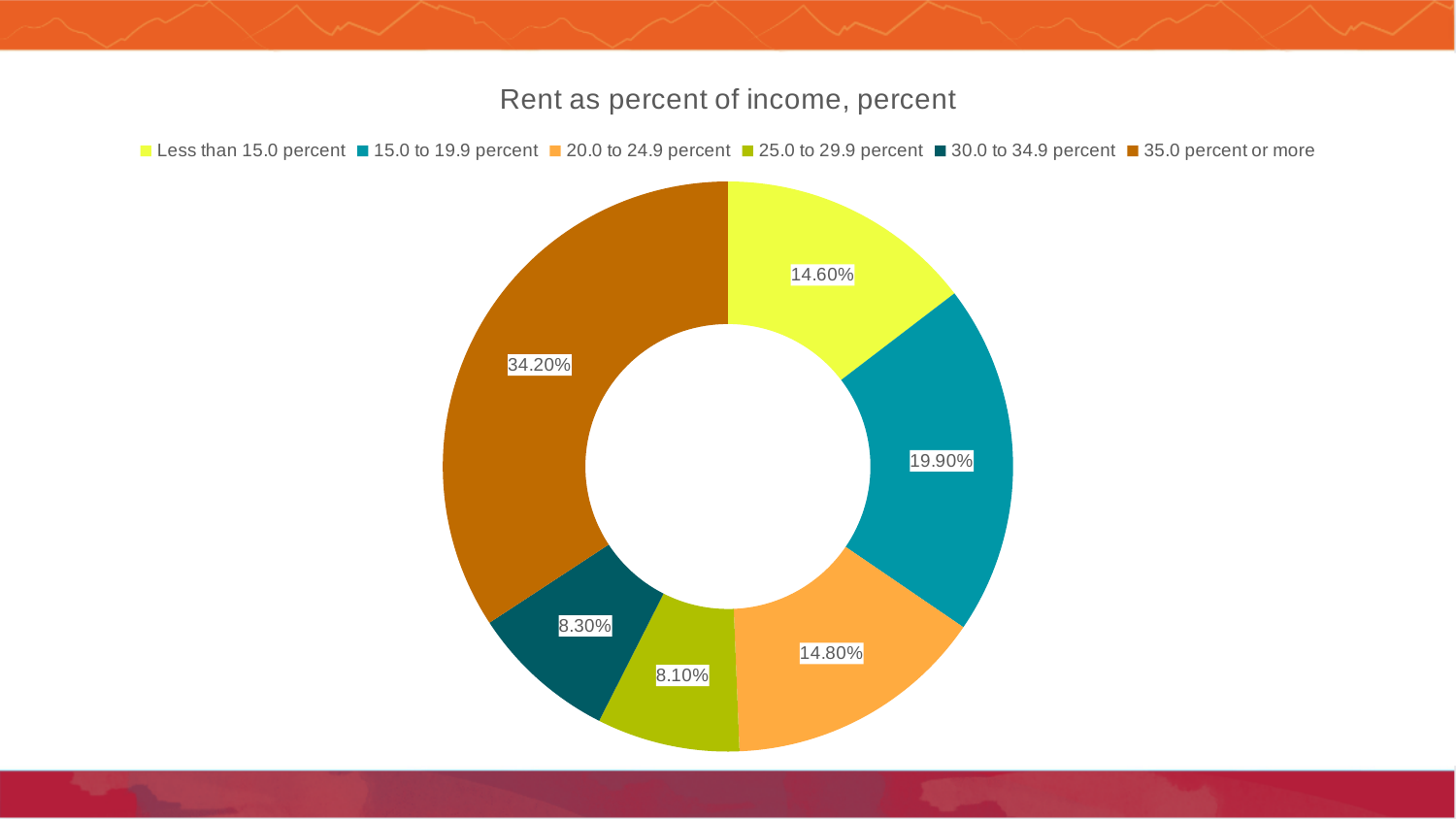
What kind of chart is shown on the slide? Doughnut chart What share of the chart is labelled for the '35.0 percent or more' category? 34.20% Which is larger: the share for '20.0 to 24.9 percent' or the share for '30.0 to 34.9 percent'? 20.0 to 24.9 percent What is the difference between the '35.0 percent or more' share and the '15.0 to 19.9 percent' share? 14.30% How many categories are shown in the chart? 6 What value is shown for the '25.0 to 29.9 percent' category? 8.10% What is the title of the chart? Rent as percent of income, percent Which category has the largest share of the chart? 35.0 percent or more Which category has the smallest share of the chart? 25.0 to 29.9 percent What value is shown for the 'Less than 15.0 percent' category? 14.60% What colour is the segment for '35.0 percent or more'? Brown/dark orange What value is shown for the '15.0 to 19.9 percent' category? 19.90%